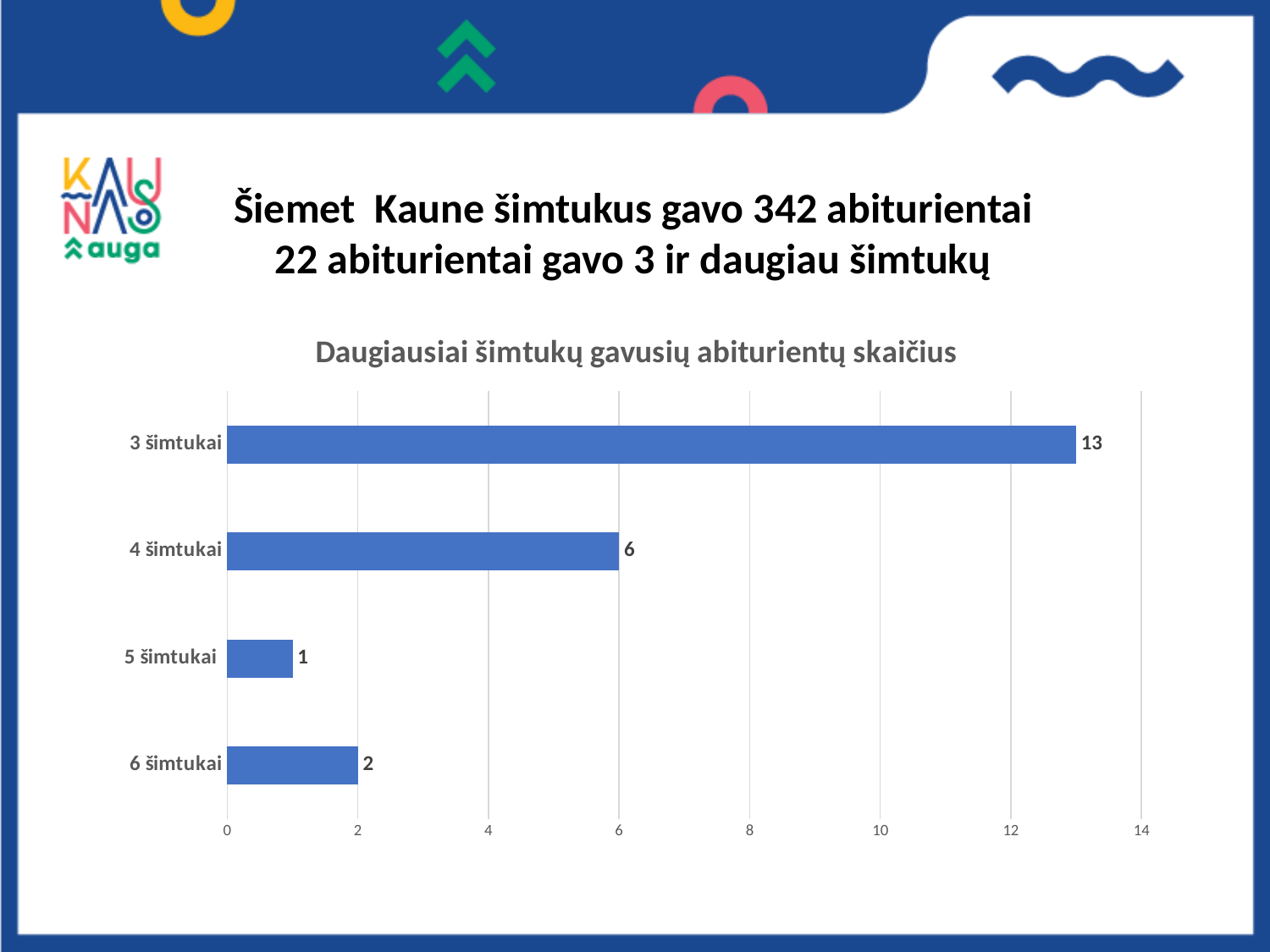
What is the value for 4 šimtukai? 6 Which category has the lowest value? 5 šimtukai What is the value for 5 šimtukai? 1 What kind of chart is shown on the slide? bar chart What is the difference between the values for 3 šimtukai and 4 šimtukai? 7 Which category has the highest value? 3 šimtukai How many categories are shown in the chart? 4 What is the value for 6 šimtukai? 2 Is the value for 3 šimtukai greater or less than 12? greater What is the title of the chart? Daugiausiai šimtukų gavusių abiturientų skaičius Which is larger, the value for 5 šimtukai or 6 šimtukai? 6 šimtukai What is the value for 3 šimtukai? 13